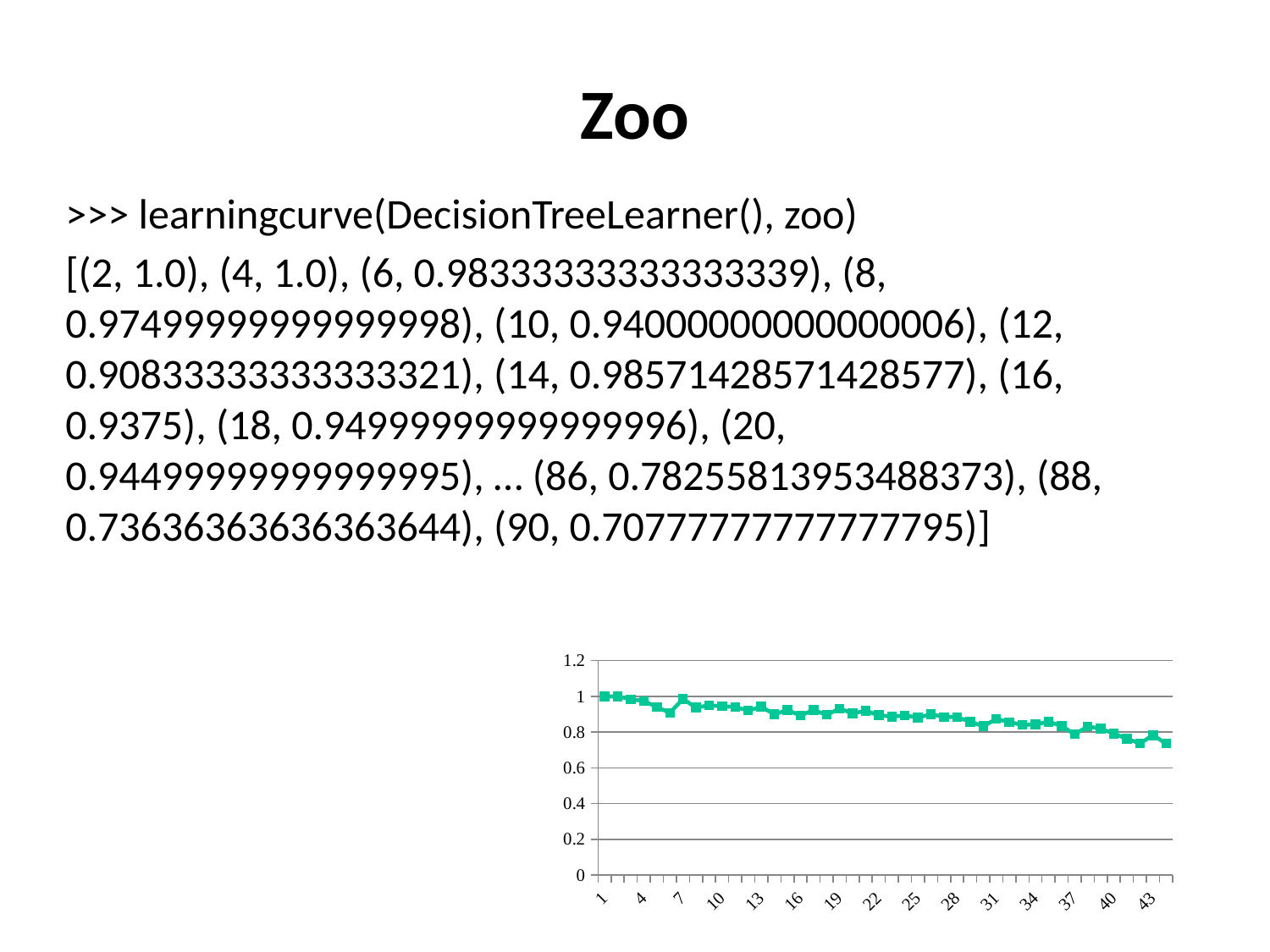
What is the highest tick value shown on the y axis? 1.2 What colour is the plotted line? green What kind of chart is shown on the slide? line chart Is the value at x = 25 greater or less than 1? less Is the value at x = 25 greater or less than 0.6? greater Is the value at x = 43 greater or less than 0.6? greater Is the lowest value of the series at the start or at the end of the x axis? at the end Do the plotted values generally rise or fall as the x axis increases? fall How many data series are plotted in the chart? 1 Which is larger, the value at x = 1 or the value at x = 43? x = 1